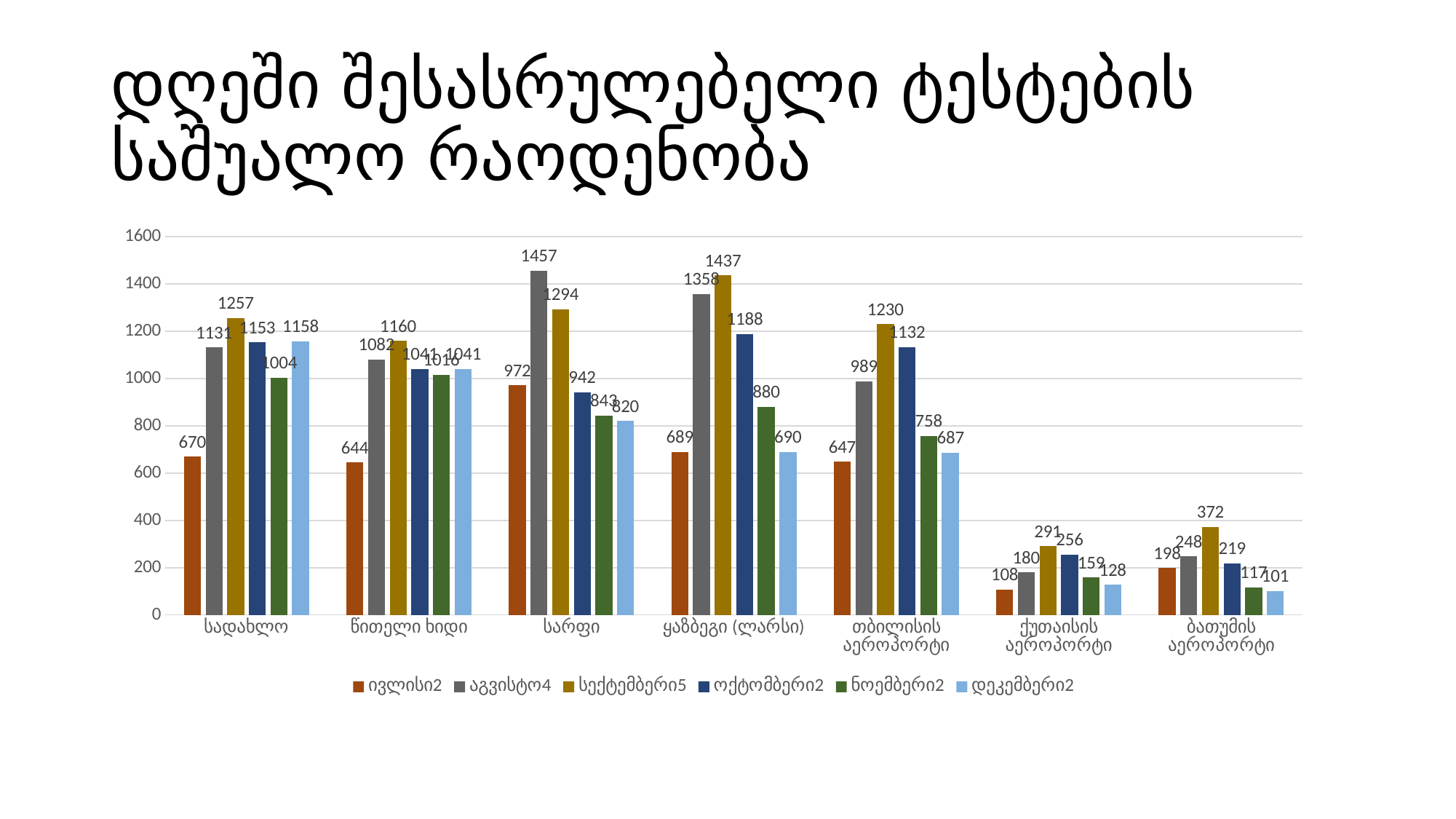
What is the title of the chart on the slide? დღეში შესასრულებელი ტესტების საშუალო რაოდენობა How many series does the legend list? 6 Which series has the lowest value in the ქუთაისის აეროპორტი category? ივლისი2 What is the value for დეკემბერი2 in the ბათუმის აეროპორტი category? 101 Is the value for ოქტომბერი2 in the სარფი category greater or less than 1000? less What is the value for სექტემბერი5 in the სადახლო category? 1257 Which is larger in the წითელი ხიდი category: the value for აგვისტო4 or the value for ნოემბერი2? აგვისტო4 How many categories are shown on the x axis? 7 What is the value for აგვისტო4 in the სარფი category? 1457 Which series has the highest value in the ყაზბეგი (ლარსი) category? სექტემბერი5 What type of chart is shown on the slide? bar chart What is the difference between the სექტემბერი5 and ივლისი2 values in the თბილისის აეროპორტი category? 583